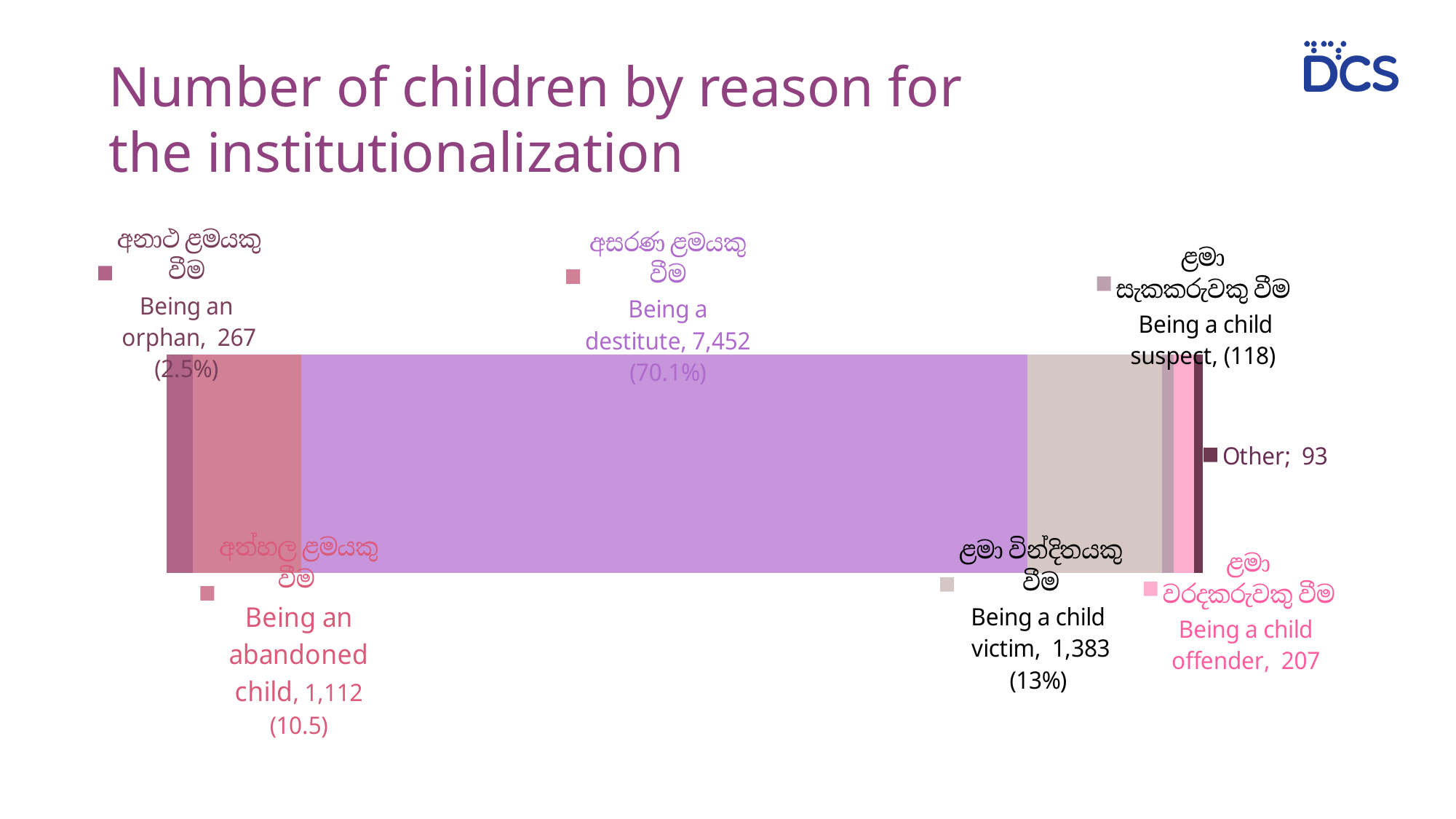
How many reason categories are shown in the chart? 7 How many children were institutionalized for being a child victim? 1,383 Which reason for institutionalization accounts for the largest number of children? Being a destitute How many children were institutionalized for being a destitute? 7,452 What percentage of children were institutionalized for being an orphan? 2.5% How many children were institutionalized for being a child offender? 207 What type of chart is used on this slide? Stacked bar chart What is the value shown for the 'Other' category? 93 Which reason for institutionalization accounts for the smallest number of children? Other Which is larger: the number of children who are orphans or the number who are child offenders? Being an orphan What is the difference between the number of children who are child victims and the number who are abandoned children? 271 How many children were institutionalized for being an abandoned child? 1,112